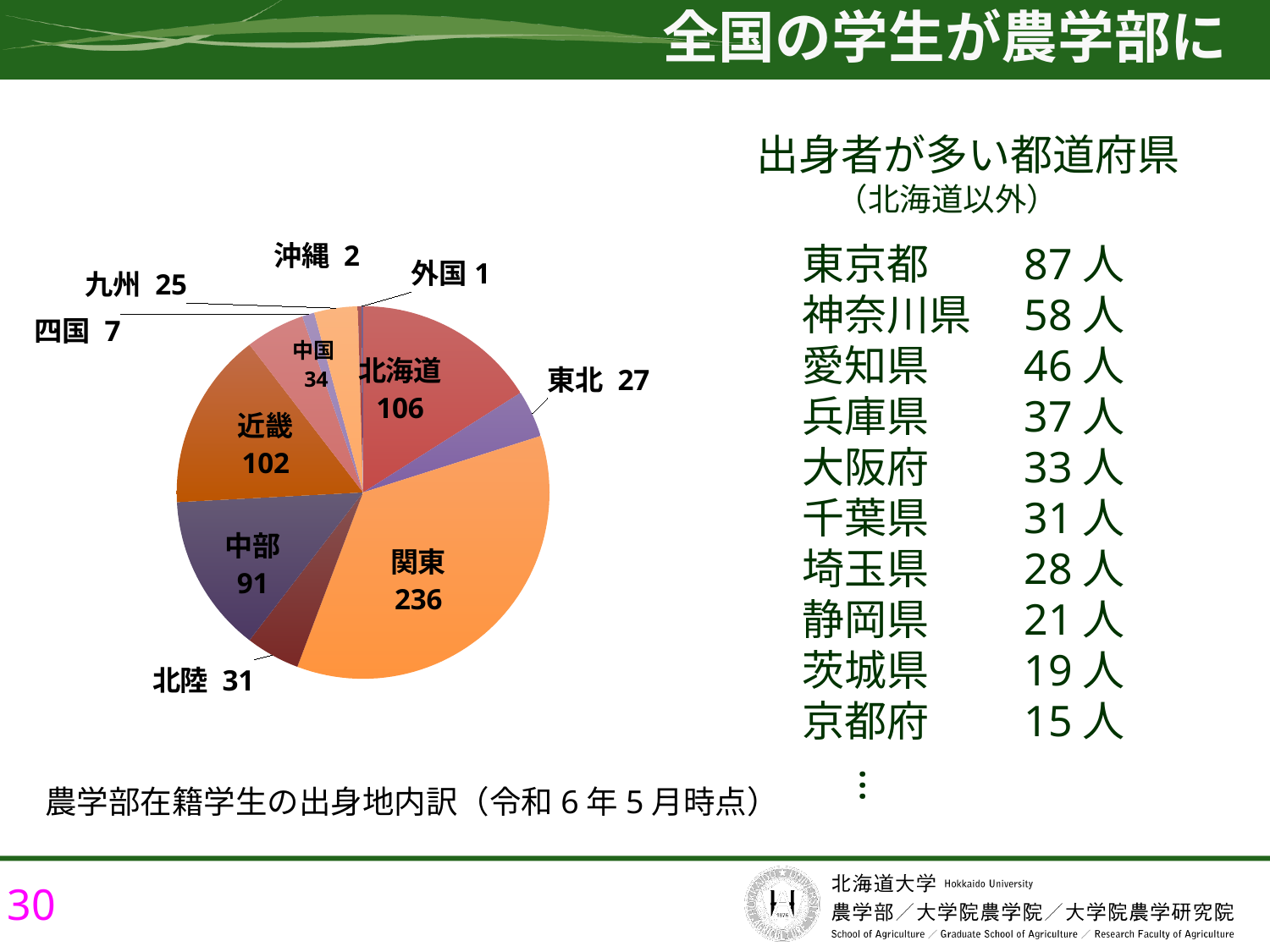
How many slices (categories) does the pie chart have? 11 What is the difference between the values for 近畿 and 中部? 11 What is the value for 中国 in the pie chart? 34 What kind of chart is shown on the slide? Pie chart Which is larger, the value for 九州 or the value for 東北? 東北 What is the difference between the values for 関東 and 北海道? 130 Which category has the smallest slice in the pie chart? 外国 What is the value for 関東 in the pie chart? 236 Which category has the largest slice in the pie chart? 関東 What is the value for 北陸 in the pie chart? 31 What is the caption shown below the pie chart? 農学部在籍学生の出身地内訳（令和6年5月時点） What is the value for 北海道 in the pie chart? 106